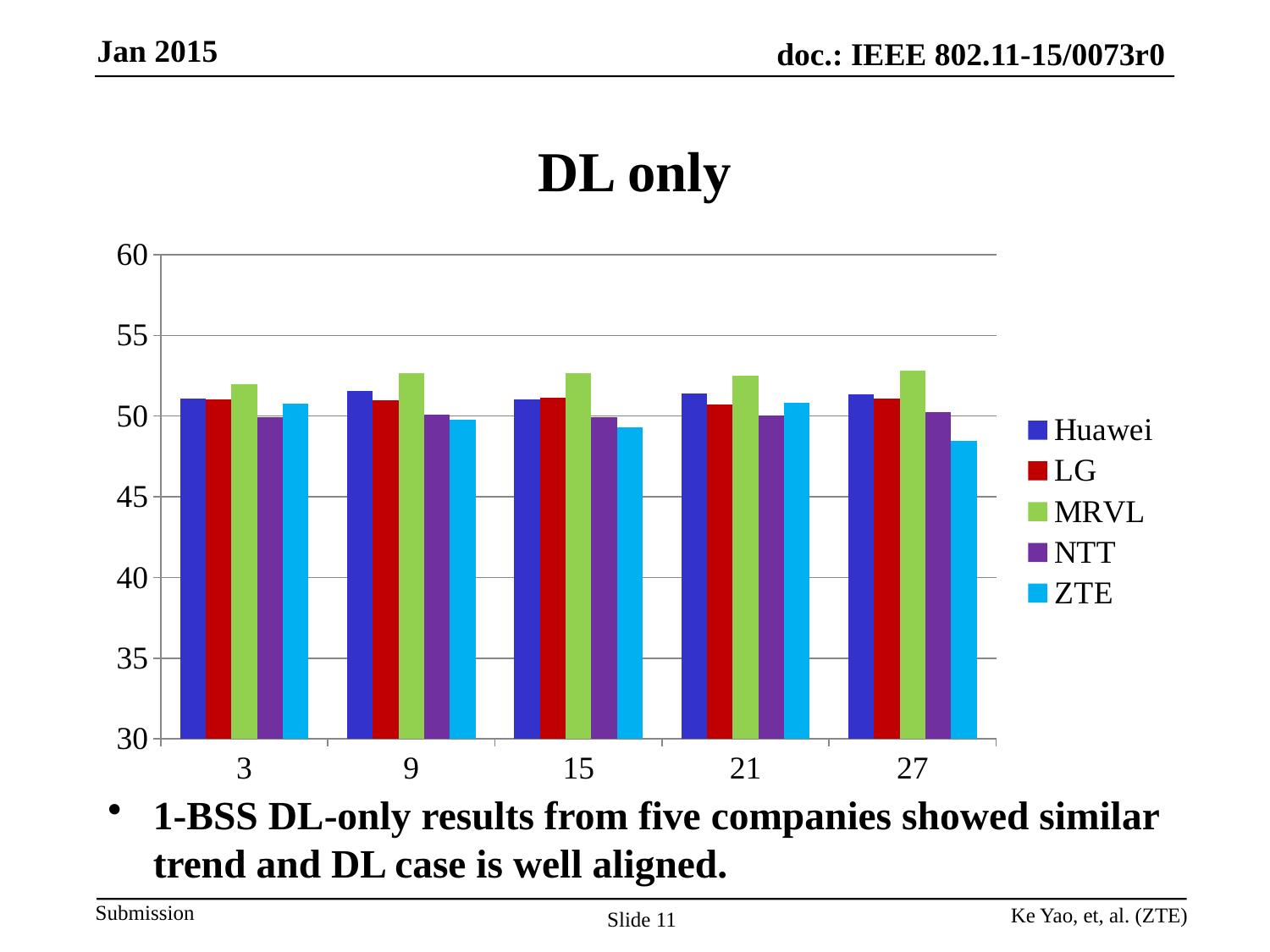
Which series has the lowest value at category 27? ZTE Which series has the highest value at category 9? MRVL Is the value for ZTE at category 27 greater or less than 50? less Is the value for MRVL at category 15 greater or less than 50? greater What is the title of the chart? DL only Which series is shown in light blue in the legend? ZTE Is the value for Huawei at category 3 greater or less than 55? less Which series has the highest value at category 27? MRVL How many series does the legend list? 5 How many categories are shown on the x axis? 5 At category 27, which is larger: the value for MRVL or the value for ZTE? MRVL What kind of chart is shown on the slide? bar chart